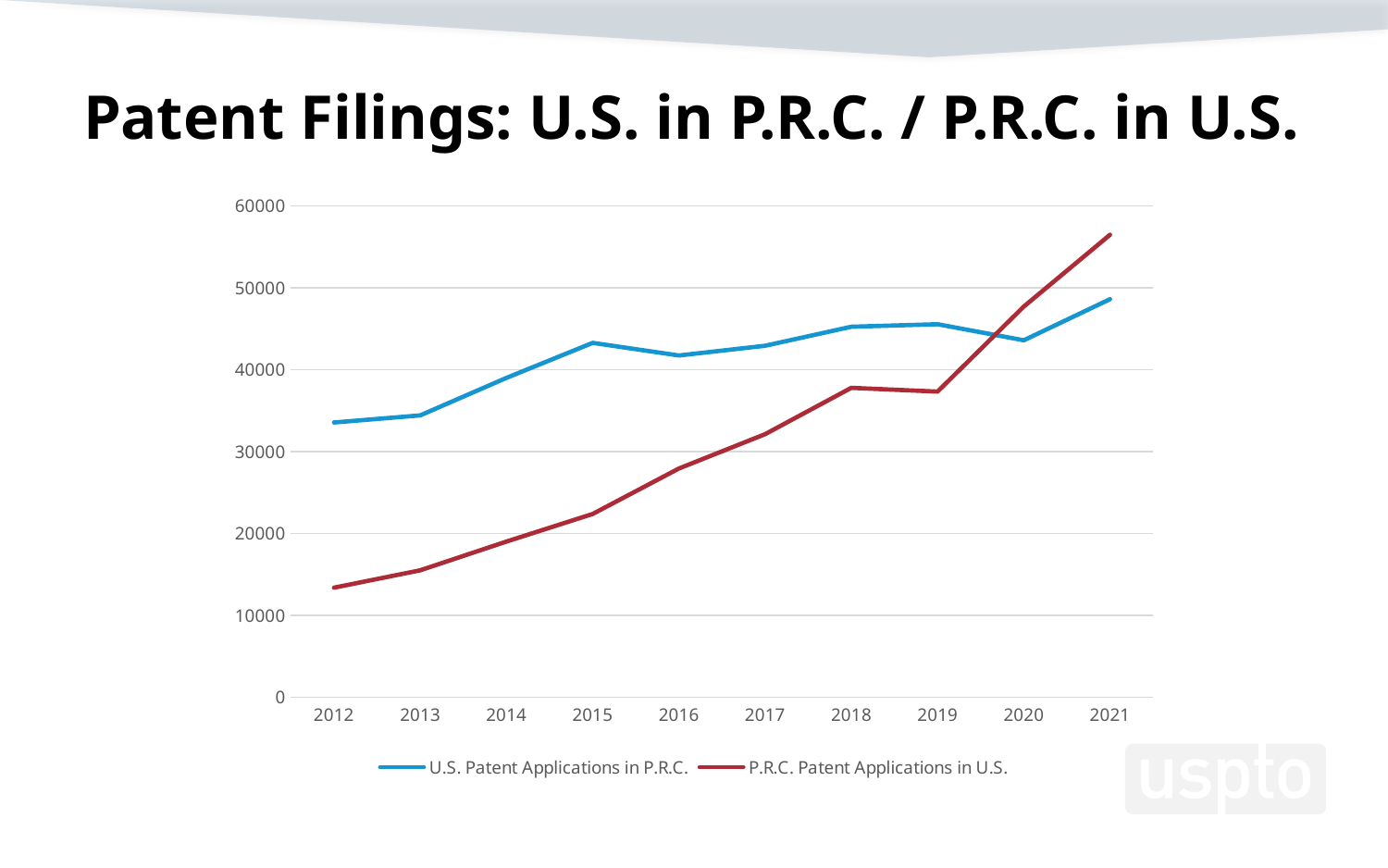
What is the title of the chart? Patent Filings: U.S. in P.R.C. / P.R.C. in U.S. How many years are plotted along the x axis? 10 Is the value for P.R.C. Patent Applications in U.S. in 2021 greater or less than 50000? greater Is the value for U.S. Patent Applications in P.R.C. in 2012 greater or less than 30000? greater Is the value for P.R.C. Patent Applications in U.S. in 2012 greater or less than 20000? less In 2021, which series has the larger value, U.S. Patent Applications in P.R.C. or P.R.C. Patent Applications in U.S.? P.R.C. Patent Applications in U.S. What kind of chart is shown on the slide? Line chart Do the values for P.R.C. Patent Applications in U.S. generally rise or fall from 2012 to 2021? Rise Which series is drawn in red? P.R.C. Patent Applications in U.S. In 2012, which series has the larger value, U.S. Patent Applications in P.R.C. or P.R.C. Patent Applications in U.S.? U.S. Patent Applications in P.R.C. How many series does the legend list? 2